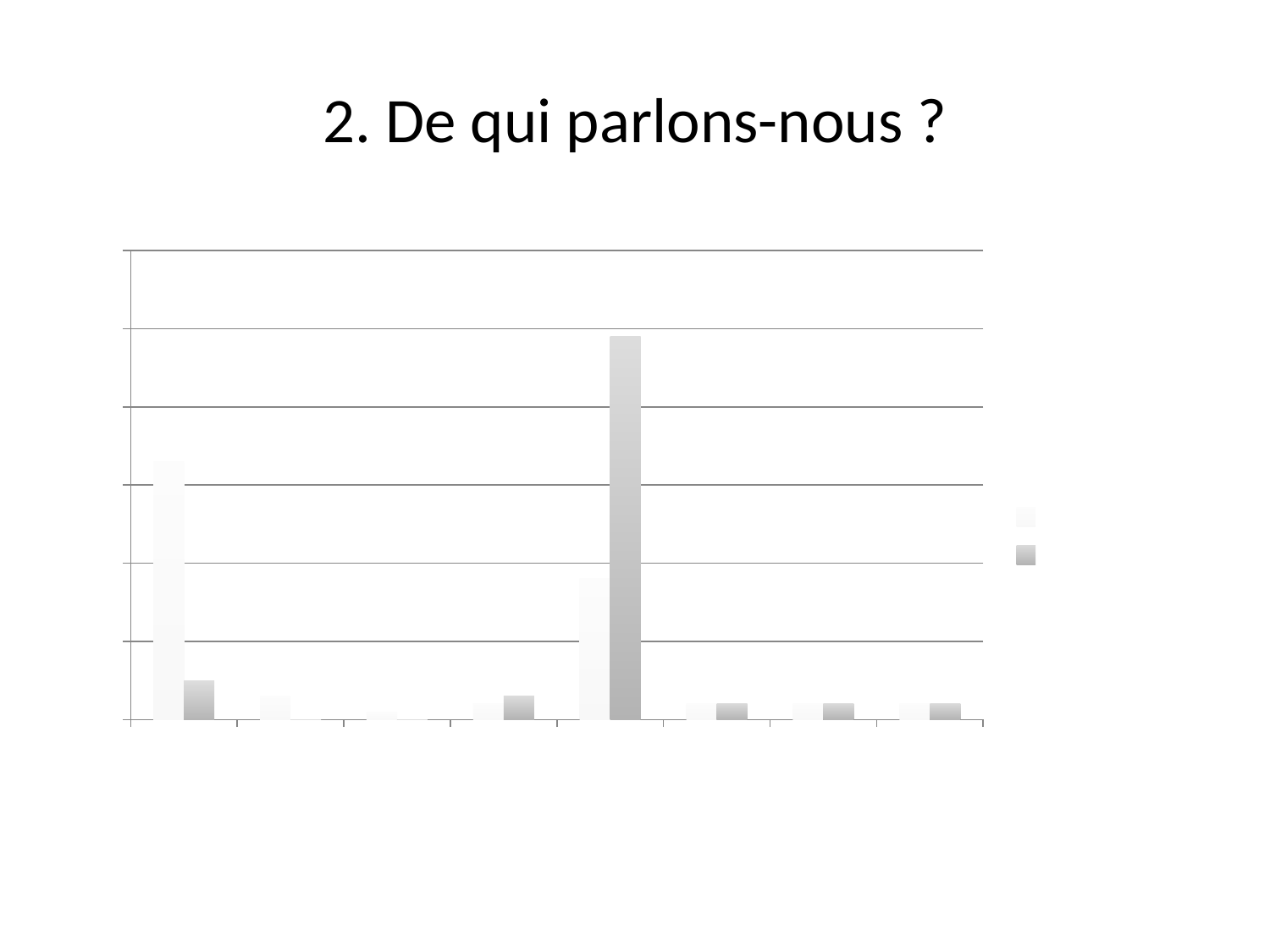
Is the tallest bar in the chart from the light grey series or the dark grey series? dark grey What kind of chart is shown on the slide? bar chart How many categories are plotted along the x axis of the chart? 8 Are the bars in the chart vertical or horizontal? vertical In the fifth category from the left, which bar is taller, the light grey one or the dark grey one? dark grey In the first category from the left, which bar is taller, the light grey one or the dark grey one? light grey Which category position from the left contains the tallest bar in the chart? fifth How many series does the chart's legend list? 2